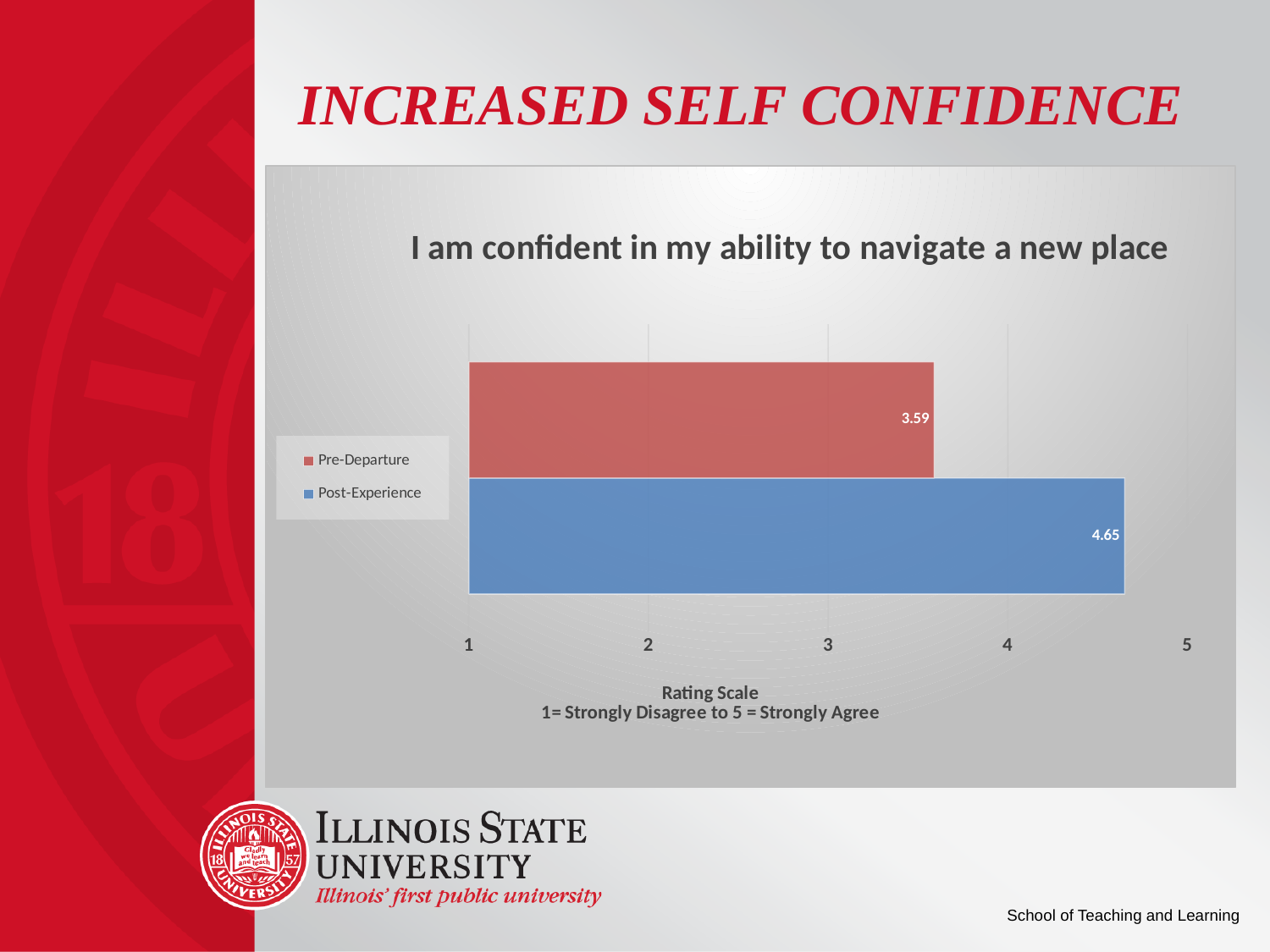
What is the highest value shown on the x axis? 5 Which series has the higher value, Pre-Departure or Post-Experience? Post-Experience Is the Post-Experience value greater or less than 4? greater How many series does the legend list? 2 What is the x-axis label of the chart? Rating Scale 1= Strongly Disagree to 5 = Strongly Agree What is the difference between the Post-Experience and Pre-Departure values? 1.06 What is the Pre-Departure value for "I am confident in my ability to navigate a new place"? 3.59 What is the Post-Experience value for "I am confident in my ability to navigate a new place"? 4.65 What kind of chart is shown on the slide? Bar chart Which series has the lowest value on the chart? Pre-Departure Is the Pre-Departure value greater or less than 4? less What is the title of the chart? I am confident in my ability to navigate a new place